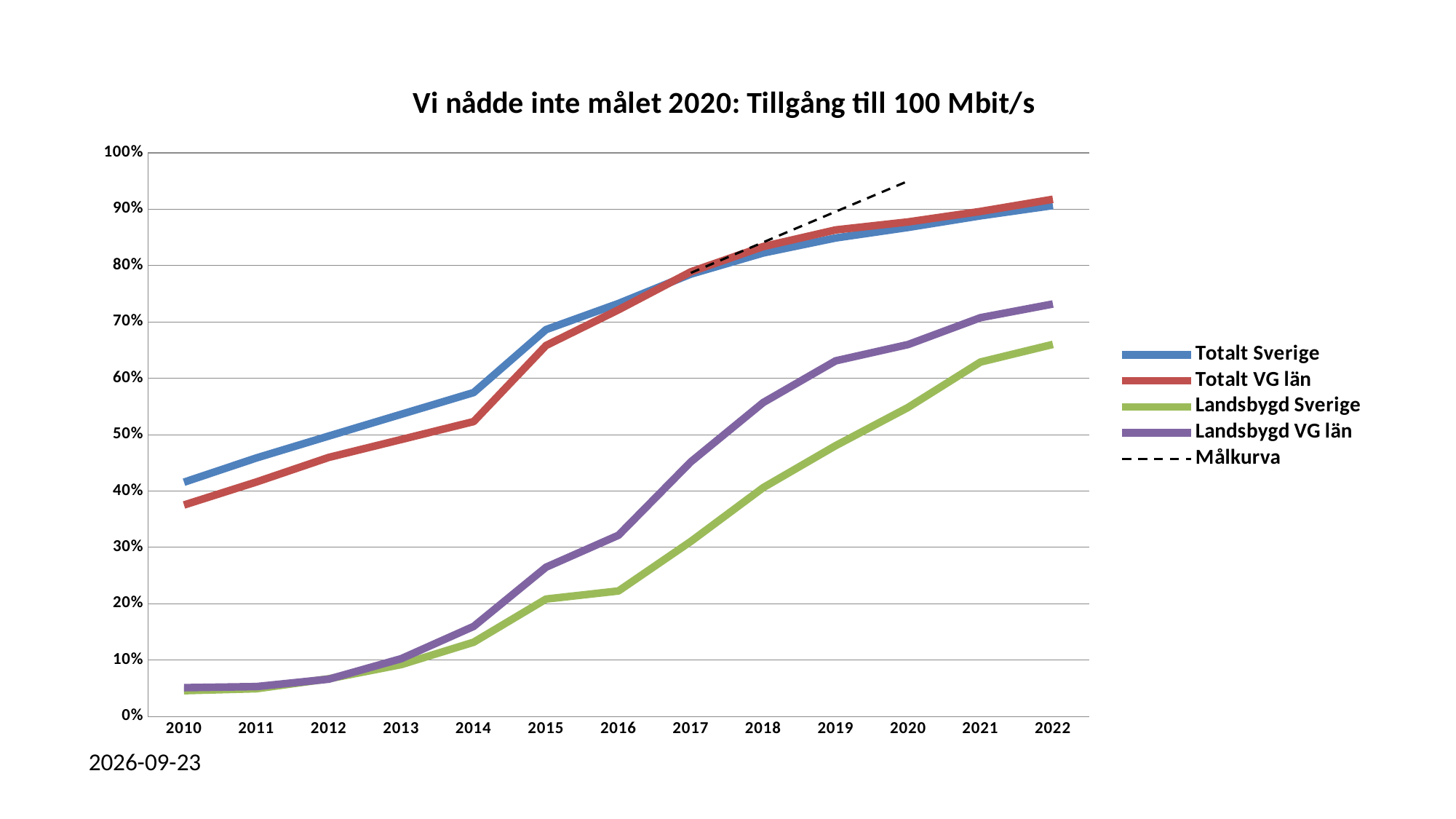
How many years are shown along the x axis? 13 How many series does the legend list? 5 What kind of chart is shown on the slide? line chart Is the value for Totalt VG län in 2010 greater or less than 40%? less Is the value for Landsbygd VG län in 2019 greater or less than 60%? greater Does the Landsbygd Sverige line rise or fall from 2010 to 2022? rise Which legend entry is drawn as a dashed line? Målkurva Is the value for Totalt Sverige in 2010 greater or less than 40%? greater Which series has the lowest value in 2022? Landsbygd Sverige In 2018, which is larger: Landsbygd VG län or Landsbygd Sverige? Landsbygd VG län